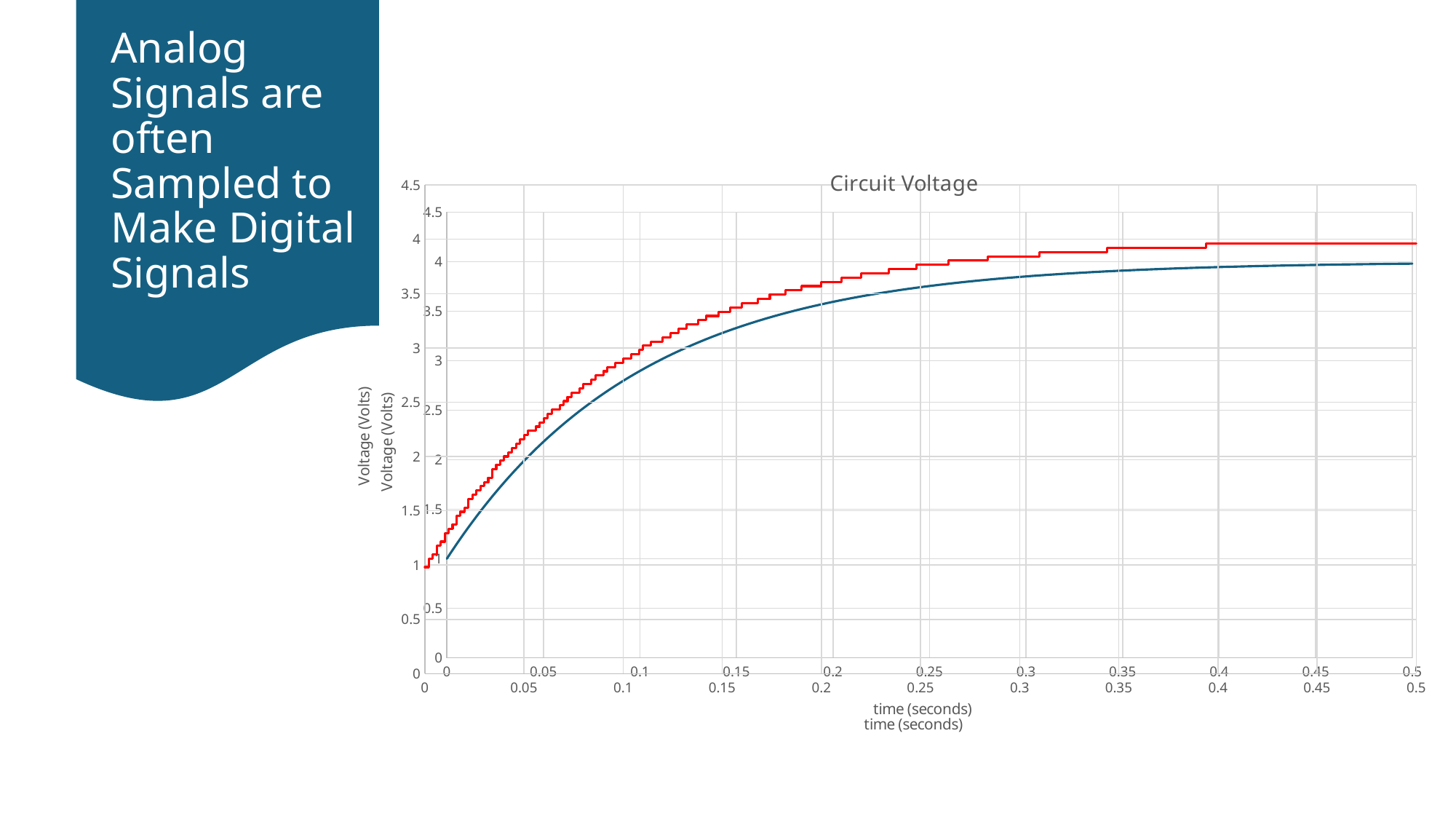
Is the value of the red stepped line at 0.5 seconds greater or less than 3.5? greater Is the value of the blue smooth line at 0.3 seconds greater or less than 3.5? greater What is the title of the chart? Circuit Voltage Is the value of the red stepped line at 0.05 seconds greater or less than 2.5? less How many lines are plotted on the chart? 2 What kind of chart is shown on the slide? line chart At 0.3 seconds, which line has the higher value, the red stepped line or the blue smooth line? the red stepped line What is the label of the x axis of the chart? time (seconds) Do the plotted voltage values rise or fall as time increases along the x axis? rise